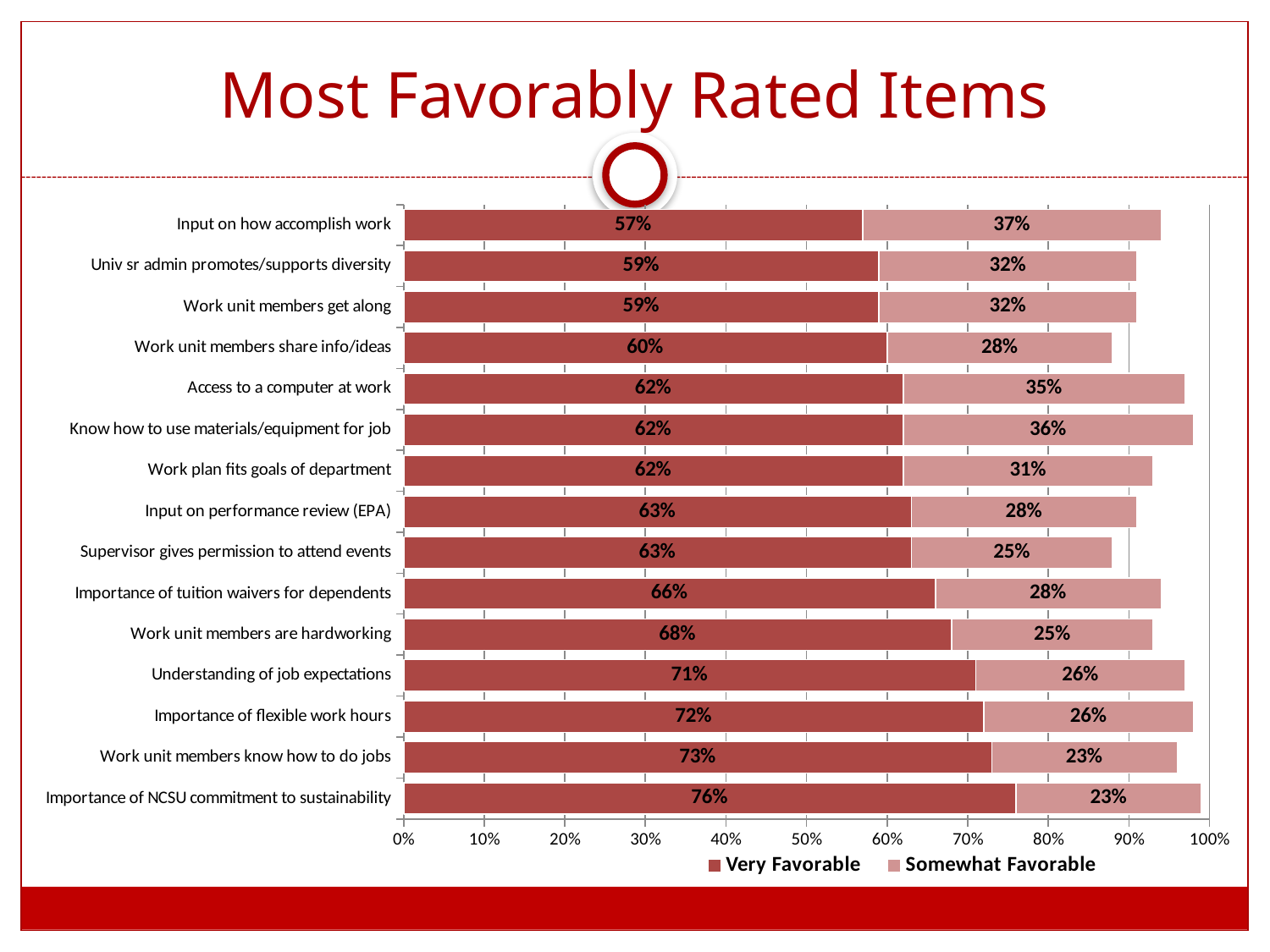
Which item has the lowest Very Favorable percentage? Input on how accomplish work What is the difference between the Very Favorable percentages for "Work unit members know how to do jobs" and "Work unit members share info/ideas"? 13% Which has a larger Very Favorable percentage: "Understanding of job expectations" or "Importance of tuition waivers for dependents"? Understanding of job expectations How many series does the legend list? 2 Which item has the highest Very Favorable percentage? Importance of NCSU commitment to sustainability How many items are listed in the chart? 15 Which item has the highest Somewhat Favorable percentage? Input on how accomplish work What is the Somewhat Favorable percentage for "Access to a computer at work"? 35% What type of chart is shown on the slide? Stacked bar chart What is the Very Favorable percentage for "Importance of flexible work hours"? 72% What is the combined Very Favorable and Somewhat Favorable total for "Know how to use materials/equipment for job"? 98% What is the combined Very Favorable and Somewhat Favorable total for "Supervisor gives permission to attend events"? 88%